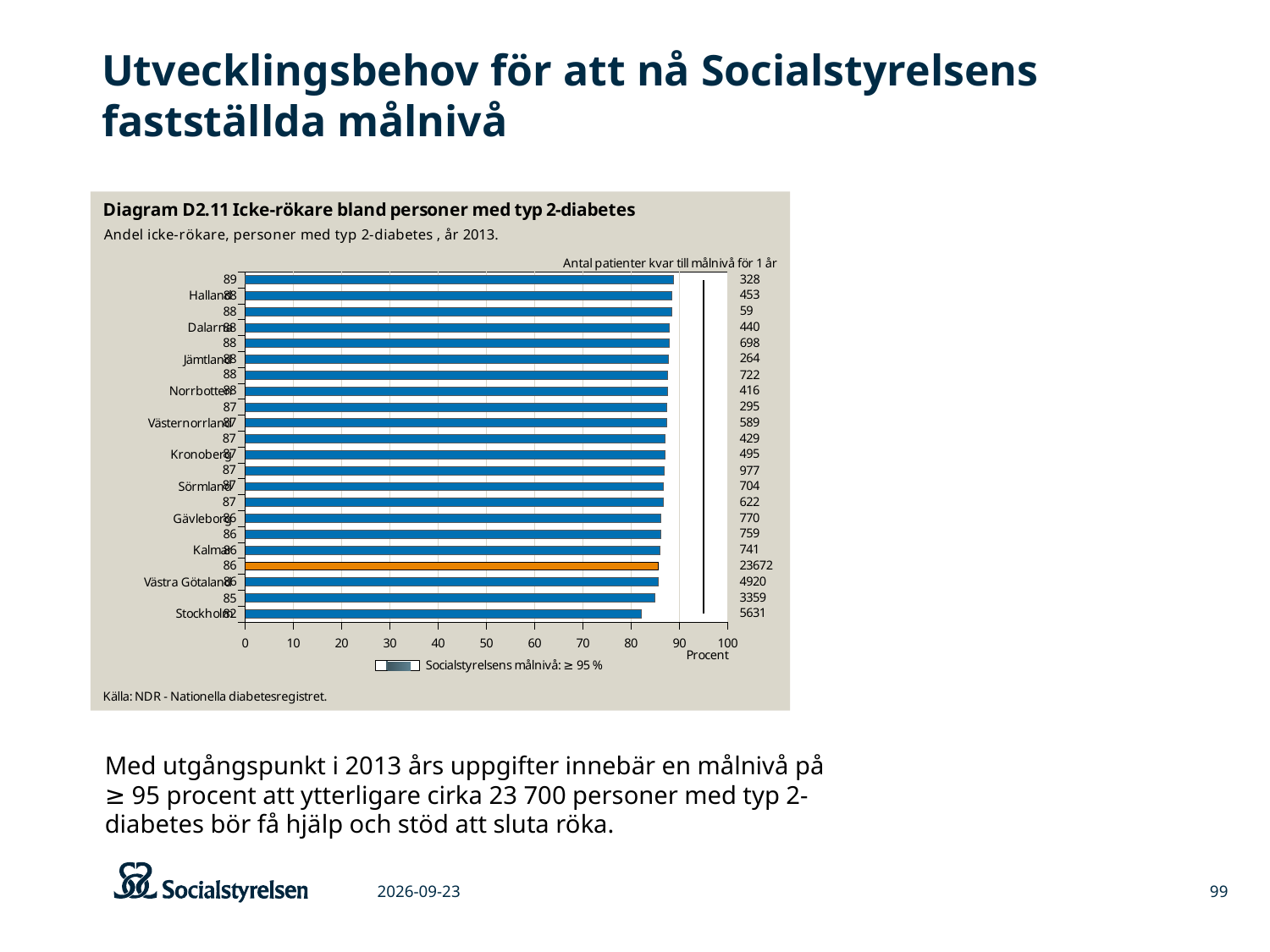
Is the value for Stockholm greater or less than 90? less How many patients remain to reach the target level (Antal patienter kvar till målnivå) for Stockholm? 5631 How many bars are plotted in the chart? 22 What is the difference between the values for Halland and Stockholm? 6 What is the value for Stockholm in the chart? 82 What is the title of the diagram? Diagram D2.11 Icke-rökare bland personer med typ 2-diabetes What target level (målnivå) does the legend state? ≥ 95 % Which labelled region has the lowest share of non-smokers in the chart? Stockholm How many patients remain to reach the target level for Västra Götaland? 4920 What kind of chart is shown on the slide? bar chart Which has a higher value, Kalmar or Stockholm? Kalmar What is the value for Halland in the chart? 88